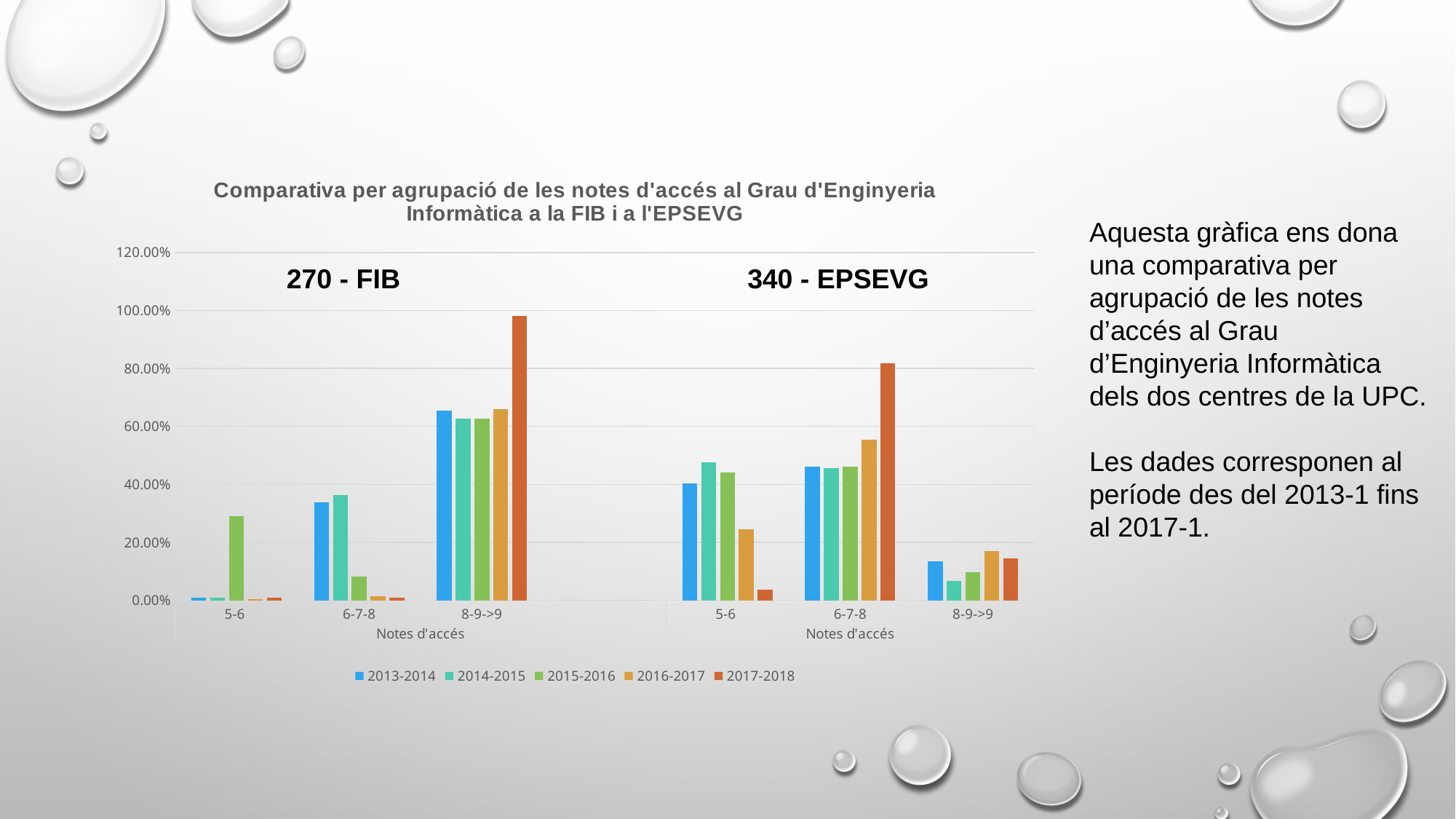
In the 340 - EPSEVG group, is the value for 2017-2018 in the 5-6 category greater or less than 20.00%? less In the 340 - EPSEVG group, which series has the lowest value in the 5-6 category? 2017-2018 How many series does the legend list? 5 In the 270 - FIB group, is the value for 2014-2015 in the 6-7-8 category greater or less than 40.00%? less In the 340 - EPSEVG group, which series has the highest value in the 6-7-8 category? 2017-2018 In the 270 - FIB group, which series has the highest value in the 5-6 category? 2015-2016 Which is larger: the 2017-2018 value for 8-9->9 in the 270 - FIB group or the 2017-2018 value for 6-7-8 in the 340 - EPSEVG group? 270 - FIB 8-9->9 What kind of chart is shown on the slide? bar chart In the 270 - FIB group, do the 2017-2018 values rise or fall from the 5-6 category to the 8-9->9 category? rise In the 340 - EPSEVG group, is the value for 2017-2018 in the 6-7-8 category greater or less than 60.00%? greater How many grade categories are shown on the x axis for the 270 - FIB group? 3